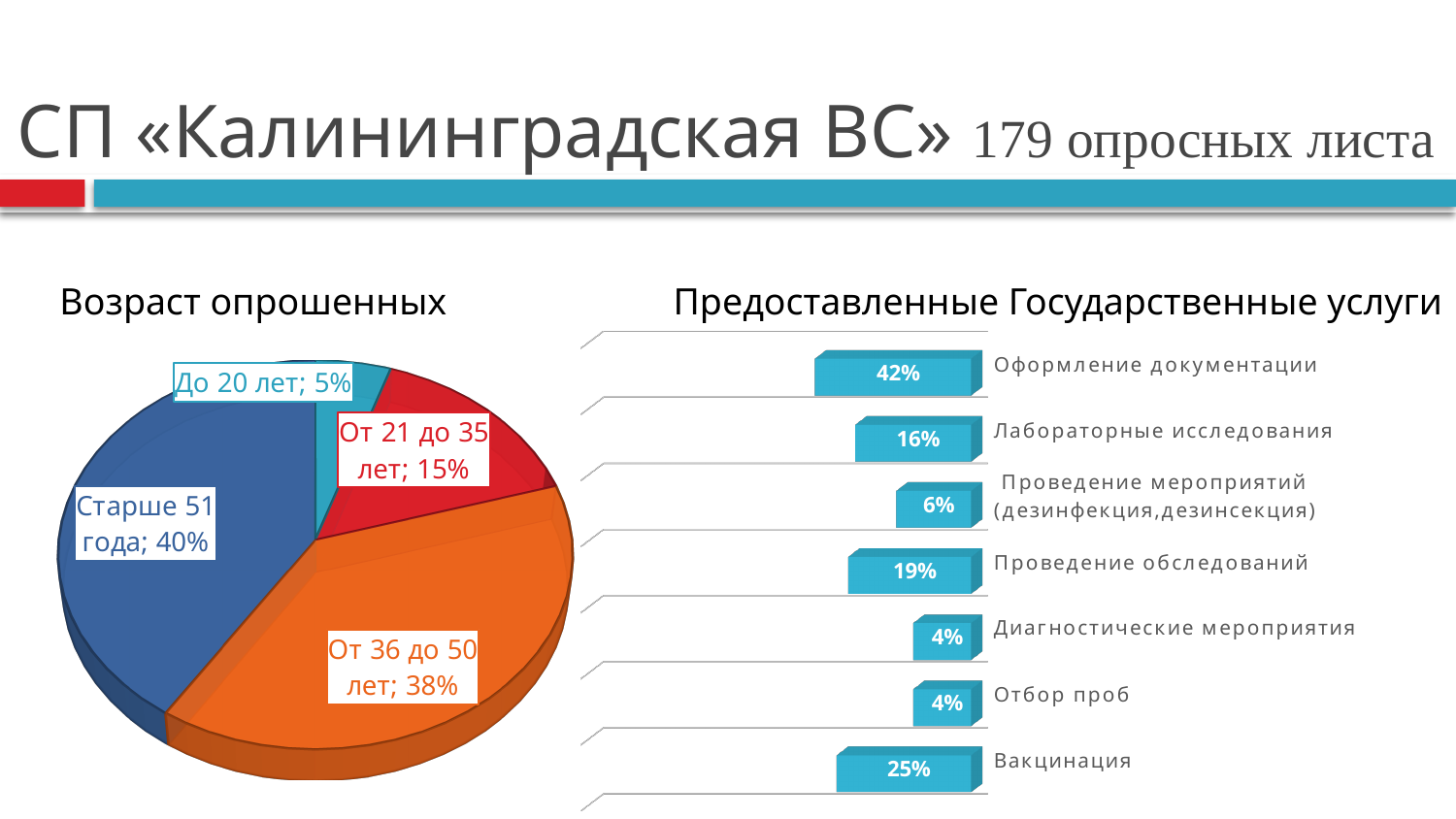
In the 'Возраст опрошенных' chart, what is the difference between the shares for 'От 36 до 50 лет' and 'От 21 до 35 лет'? 23% In the 'Возраст опрошенных' pie chart, which age group has the smallest share? До 20 лет In the 'Возраст опрошенных' pie chart, what share of respondents are 'До 20 лет'? 5% In the 'Предоставленные Государственные услуги' chart, what is the value for 'Вакцинация'? 25% In the 'Предоставленные Государственные услуги' chart, what is the value for 'Оформление документации'? 42% In the 'Предоставленные Государственные услуги' chart, how many services are listed? 7 In the 'Возраст опрошенных' pie chart, what share of respondents are 'Старше 51 года'? 40% In the 'Возраст опрошенных' pie chart, which age group has the largest share? Старше 51 года In the 'Предоставленные Государственные услуги' chart, which is larger: 'Лабораторные исследования' or 'Проведение обследований'? Проведение обследований In the 'Возраст опрошенных' pie chart, how many age groups are shown? 4 In the 'Предоставленные Государственные услуги' chart, which service has the highest value? Оформление документации What type of chart is 'Возраст опрошенных'? Pie chart